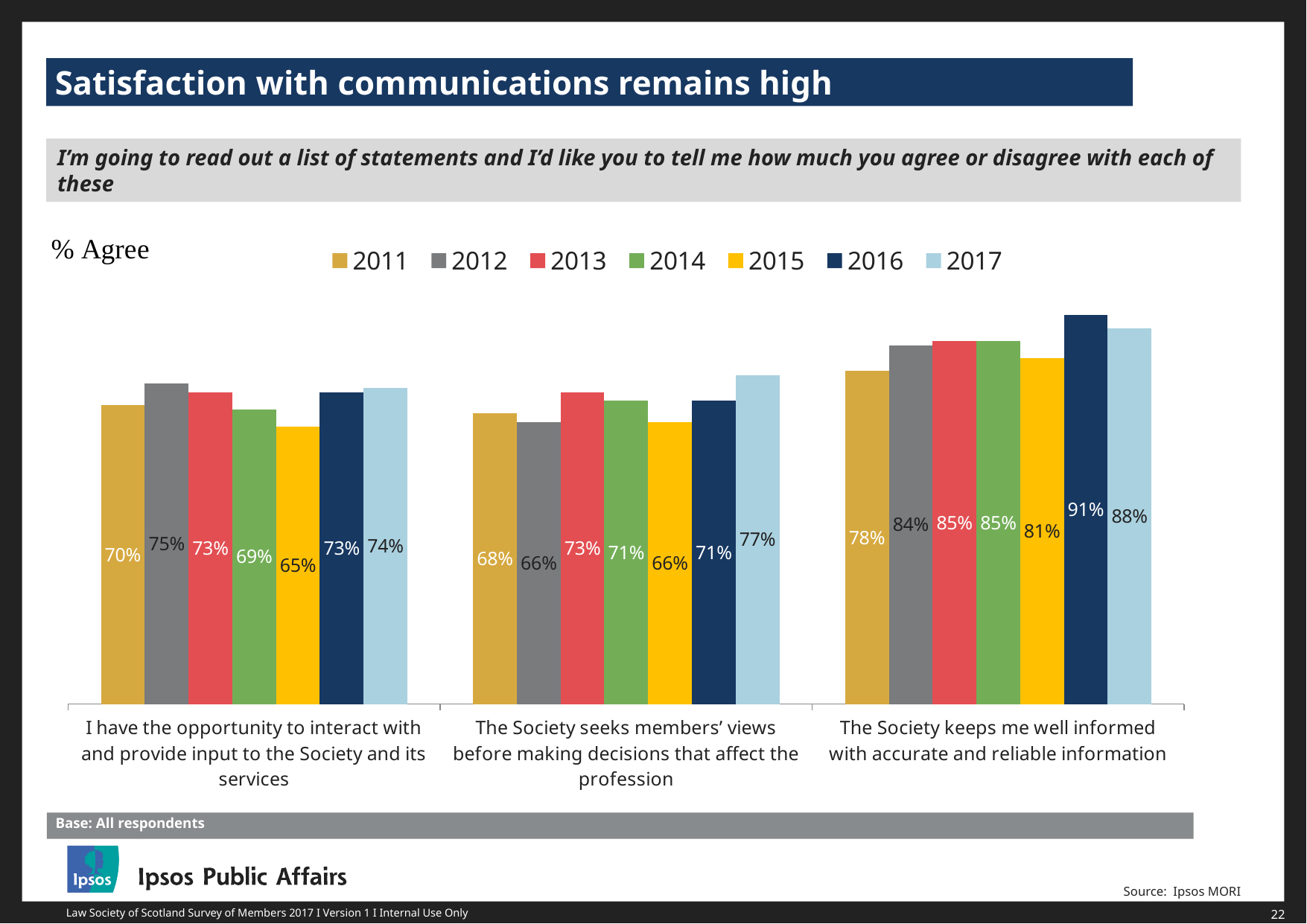
What colour represents 2015 in the legend? Yellow Which year had the highest value for 'The Society keeps me well informed with accurate and reliable information'? 2016 What kind of chart is shown on the slide? Bar chart What was the 2015 value for 'I have the opportunity to interact with and provide input to the Society and its services'? 65% What percentage agreed in 2013 that the Society seeks members' views before making decisions that affect the profession? 73% How many statement categories are shown on the x axis? 3 How many series does the legend list? 7 What percentage agreed in 2017 that the Society keeps them well informed with accurate and reliable information? 88% Which year had the lowest value for 'I have the opportunity to interact with and provide input to the Society and its services'? 2015 What is the difference between the 2017 and 2016 values for 'The Society seeks members' views before making decisions that affect the profession'? 6 percentage points Did the value for 'The Society keeps me well informed with accurate and reliable information' rise or fall from 2016 to 2017? Fall Which is larger: the 2012 value for 'I have the opportunity to interact with and provide input to the Society and its services' or the 2012 value for 'The Society seeks members' views before making decisions that affect the profession'? I have the opportunity to interact with and provide input to the Society and its services